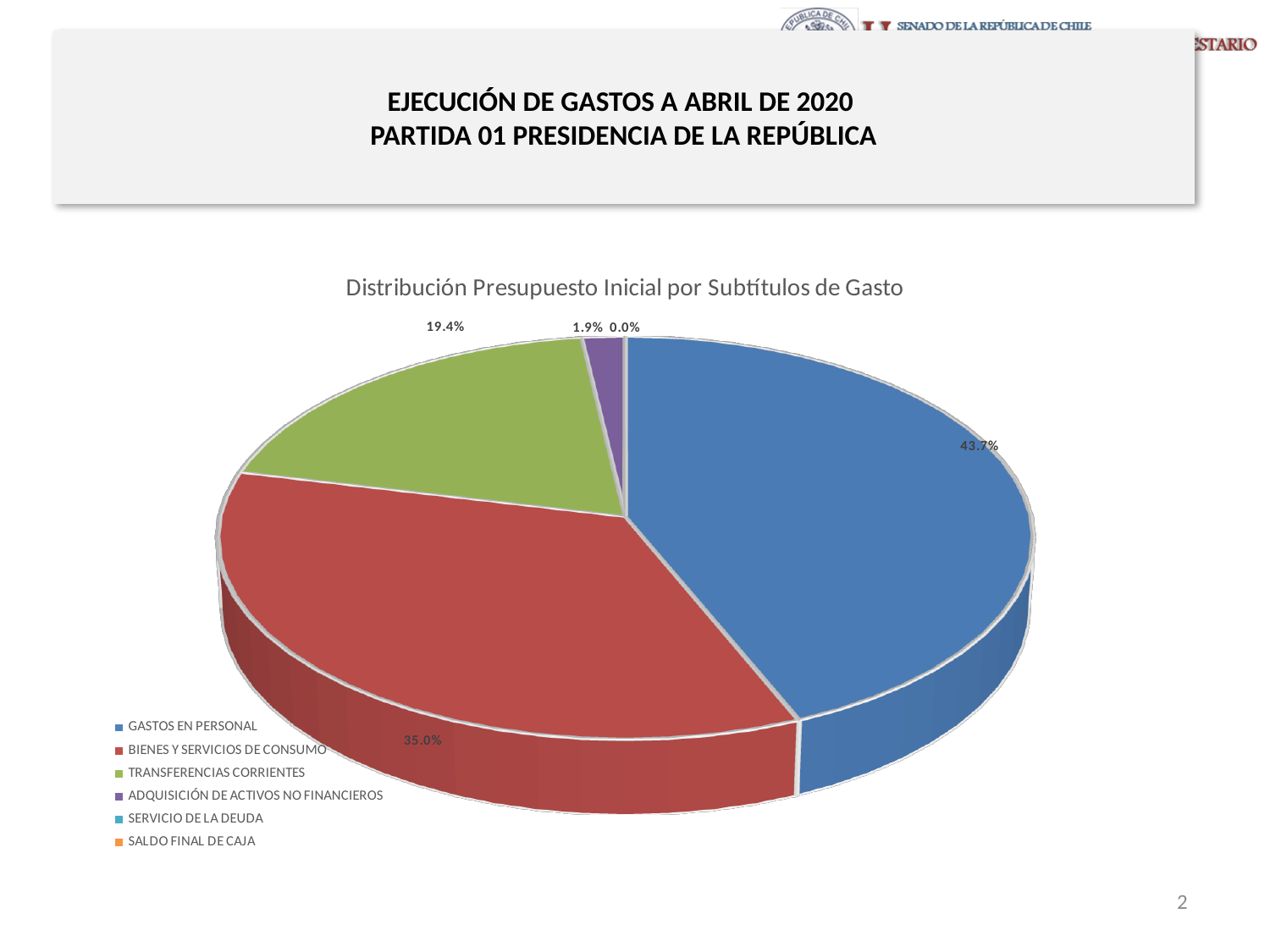
What share of the pie does GASTOS EN PERSONAL represent? 43.7% What is the value shown for ADQUISICIÓN DE ACTIVOS NO FINANCIEROS? 1.9% What is the difference between the shares of BIENES Y SERVICIOS DE CONSUMO and TRANSFERENCIAS CORRIENTES? 15.6 percentage points What is the value shown for TRANSFERENCIAS CORRIENTES? 19.4% What kind of chart is shown on the slide? Pie chart Which category has the largest slice of the pie? GASTOS EN PERSONAL What is the difference between the shares of GASTOS EN PERSONAL and BIENES Y SERVICIOS DE CONSUMO? 8.7 percentage points What is the title of the pie chart? Distribución Presupuesto Inicial por Subtítulos de Gasto How many categories does the legend of the pie chart list? 6 What colour is the slice for GASTOS EN PERSONAL? Blue Which is larger, the share for TRANSFERENCIAS CORRIENTES or the share for ADQUISICIÓN DE ACTIVOS NO FINANCIEROS? TRANSFERENCIAS CORRIENTES What is the value shown for BIENES Y SERVICIOS DE CONSUMO? 35.0%